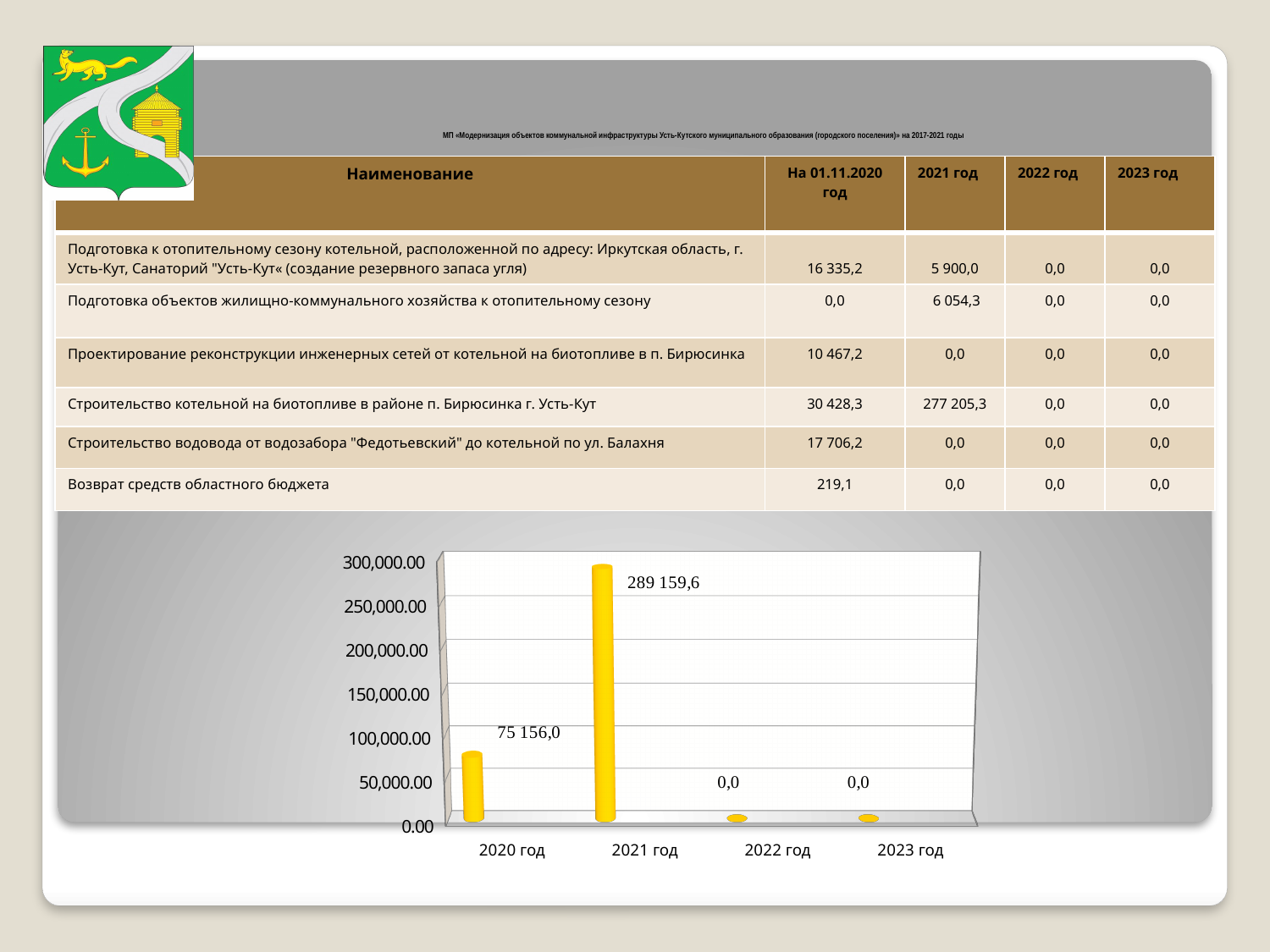
Which year has the highest value in the chart? 2021 год Is the value for 2021 год greater or less than 250,000.00 in the chart? greater What is the value shown for 2021 год in the chart? 289 159,6 Which of the two, 2020 год or 2021 год, has the larger value in the chart? 2021 год How many categories are shown on the x axis of the chart? 4 What is the value shown for 2020 год in the chart? 75 156,0 What is the value shown for 2023 год in the chart? 0,0 What kind of chart is shown on the slide? bar chart What is the value shown for 2022 год in the chart? 0,0 What is the highest value labelled on the vertical axis of the chart? 300,000.00 Is the value for 2020 год greater or less than 100,000.00 in the chart? less What is the difference between the values for 2021 год and 2020 год in the chart? 214 003,6